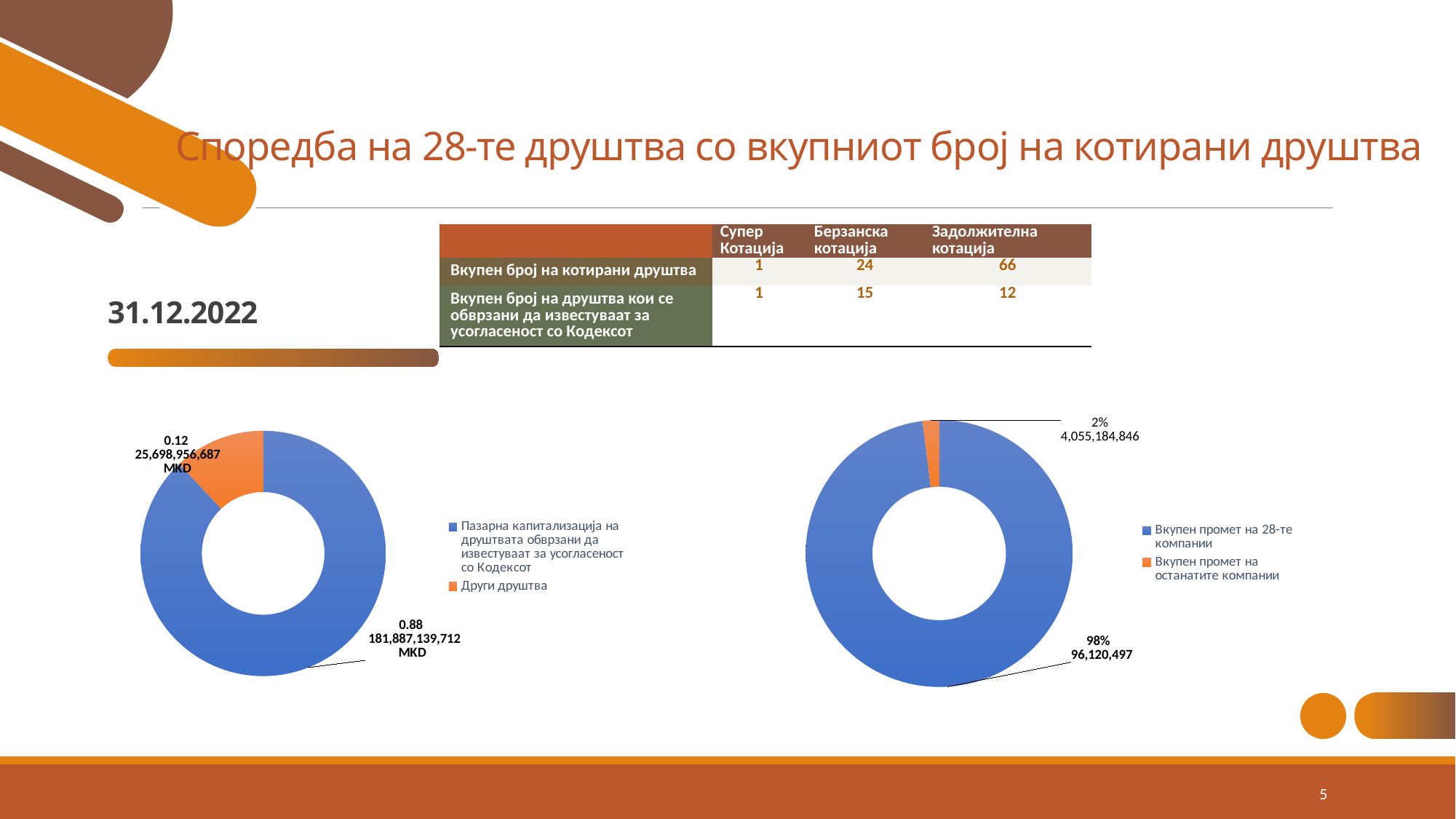
How many entries does the legend of the right chart list? 2 In the right chart, what value is labelled for 'Вкупен промет на 28-те компании'? 96,120,497 In the right chart, which category has the smallest slice? Вкупен промет на останатите компании In the right chart, what share of the doughnut does 'Вкупен промет на 28-те компании' represent? 98% What kind of chart is the chart on the right of the slide? Doughnut (pie) chart What kind of chart is the chart on the left of the slide? Doughnut (pie) chart In the left chart, what value in MKD is shown for 'Пазарна капитализација на друштвата обврзани да известуваат за усогласеност со Кодексот'? 181,887,139,712 MKD In the left chart, what share of the doughnut does 'Други друштва' represent? 0.12 In the right chart, what value is labelled for 'Вкупен промет на останатите компании'? 4,055,184,846 In the left chart, what is the difference in MKD between the two labelled values? 156,188,183,025 MKD In the left chart, what value in MKD is shown for 'Други друштва'? 25,698,956,687 MKD In the left chart, which category has the largest slice? Пазарна капитализација на друштвата обврзани да известуваат за усогласеност со Кодексот